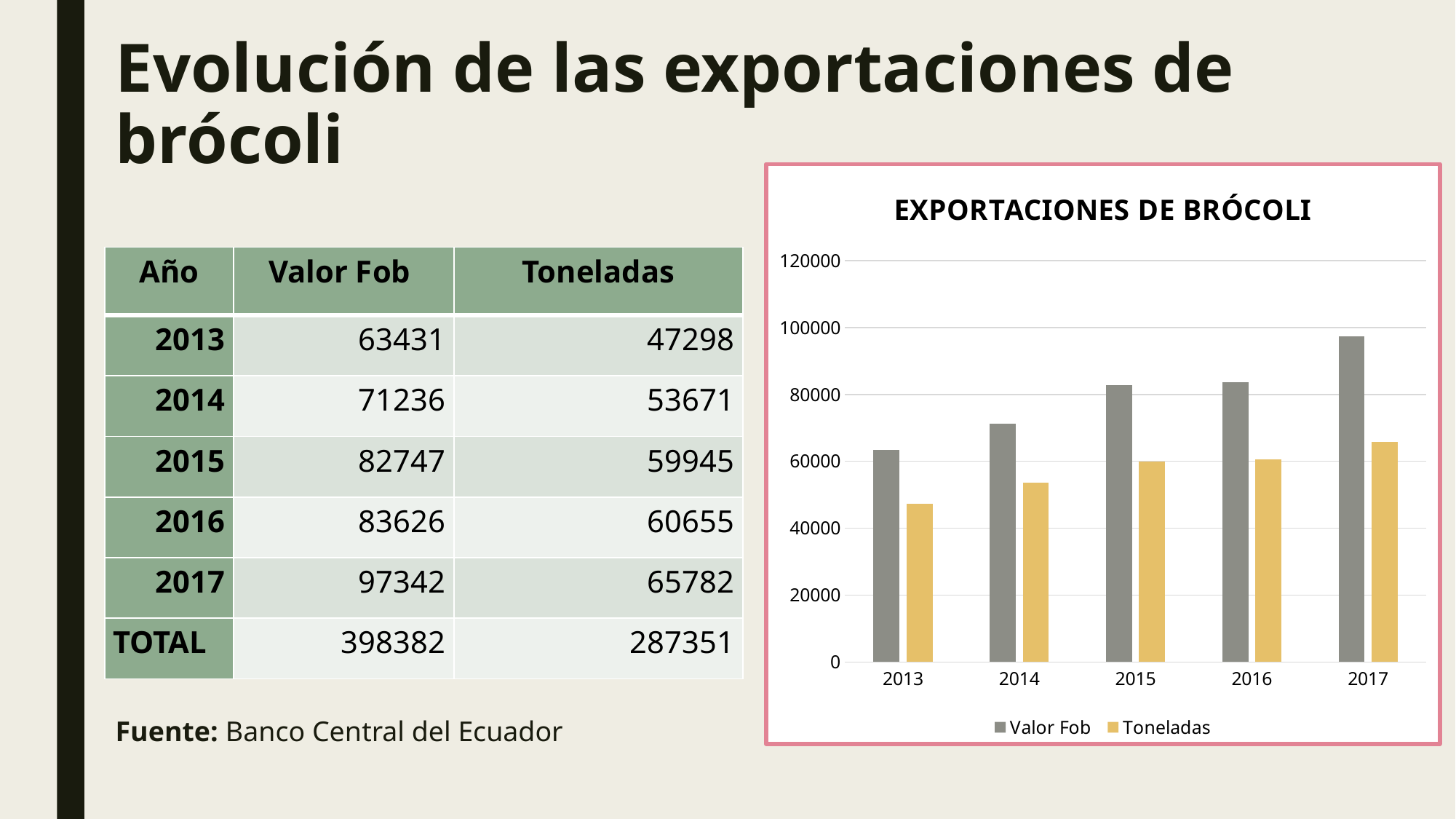
How many years are shown on the x axis of the chart? 5 What is the Valor Fob value for 2017? 97342 Which is larger in 2015, Valor Fob or Toneladas? Valor Fob Do the Valor Fob values rise or fall from 2013 to 2017? rise What is the Toneladas value for 2014? 53671 Is the Toneladas value for 2013 greater or less than 60000? less Which year has the highest Valor Fob value in the chart? 2017 Is the Valor Fob value for 2017 greater or less than 80000? greater What kind of chart is shown on the slide? bar chart Which year has the lowest Toneladas value in the chart? 2013 What is the title of the chart? EXPORTACIONES DE BRÓCOLI How many series does the chart's legend list? 2